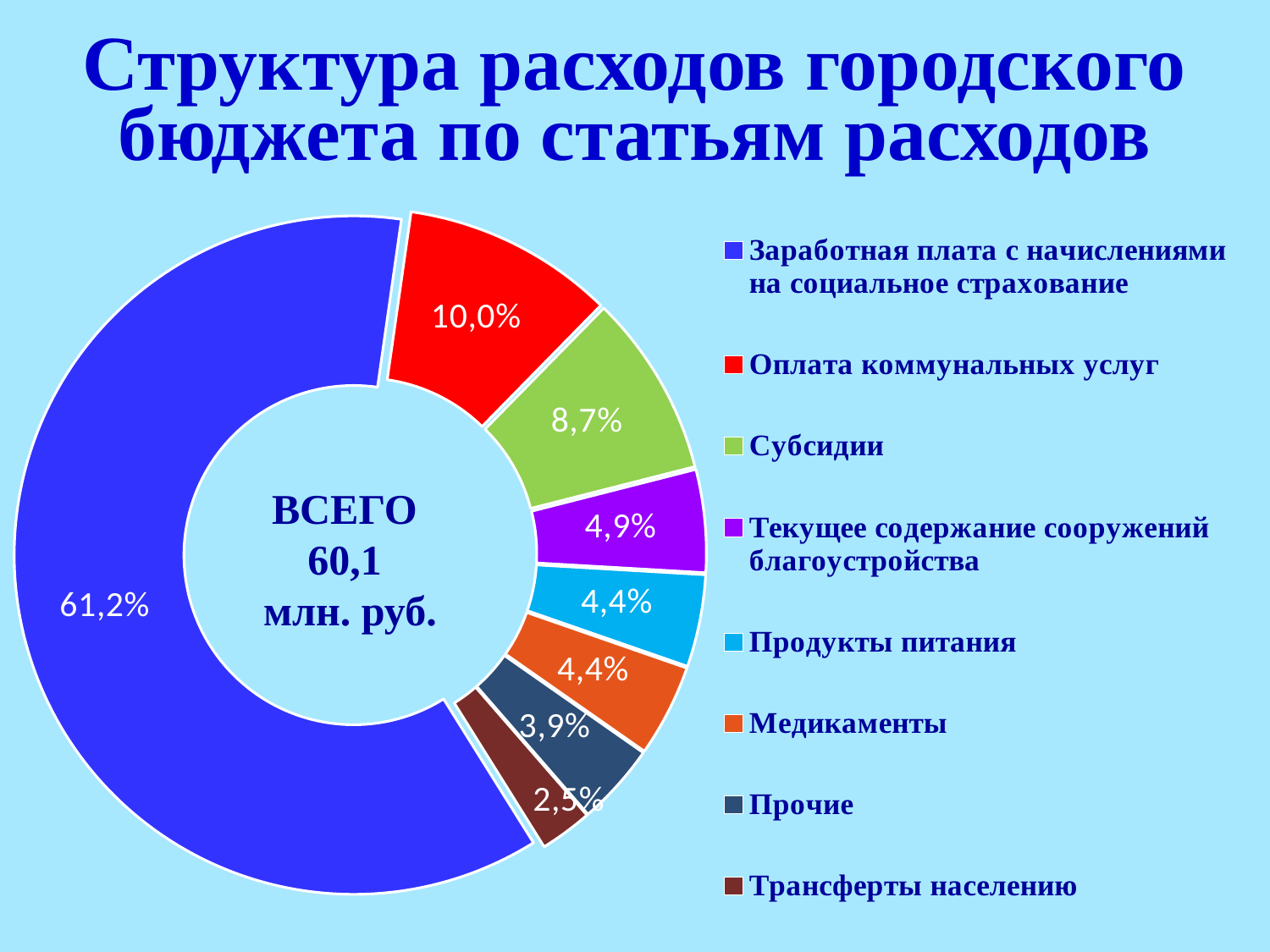
What percentage is shown for «Субсидии»? 8,7% Which is larger: the share for «Текущее содержание сооружений благоустройства» or for «Прочие»? Текущее содержание сооружений благоустройства What total amount is shown in the centre of the chart? 60,1 млн. руб. Which expenditure item has the largest share of the budget? Заработная плата с начислениями на социальное страхование What is the difference in percentage points between «Оплата коммунальных услуг» and «Субсидии»? 1,3 What percentage is shown for «Трансферты населению»? 2,5% What share of the city budget expenditures goes to «Заработная плата с начислениями на социальное страхование»? 61,2% How many expenditure categories are shown in the chart? 8 Which expenditure item has the smallest share of the budget? Трансферты населению What colour is the segment for «Медикаменты»? Orange What share of expenditures is «Оплата коммунальных услуг»? 10,0% What type of chart is shown on the slide? Doughnut (pie) chart